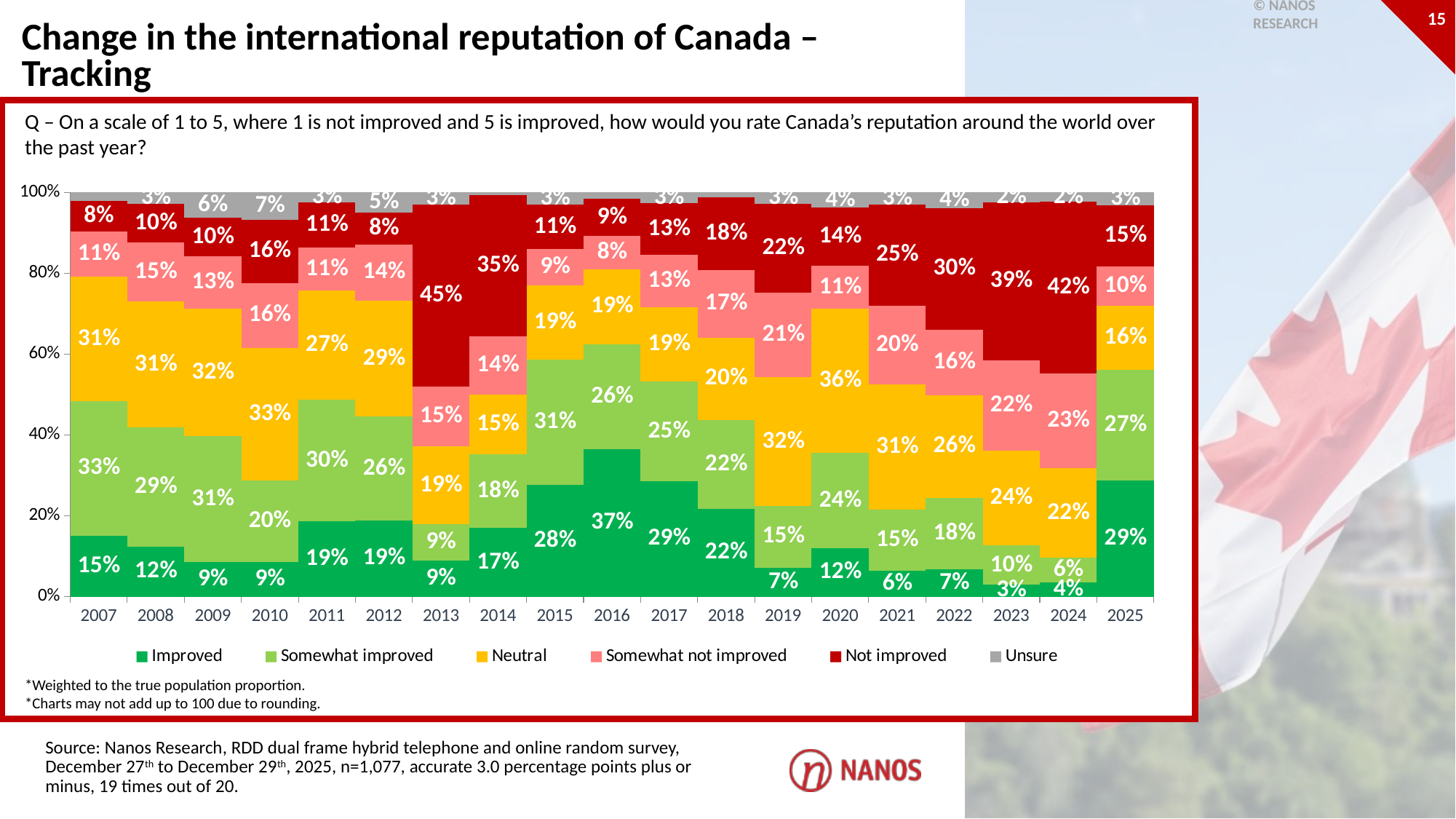
What is the "Somewhat not improved" value for 2023? 22% How many years are shown on the x axis of the chart? 19 In which year was the "Improved" share the lowest? 2023 Did the "Not improved" share rise or fall from 2021 to 2024? Rise Which year had a larger "Neutral" share, 2019 or 2020? 2020 How many series does the legend list? 6 What percentage of respondents said Canada's reputation was "Improved" in 2025? 29% By how many percentage points did the "Not improved" share fall from 2024 to 2025? 27 percentage points What colour represents the "Unsure" series in the legend? Grey What is the "Not improved" value for 2024? 42% In which year was the "Improved" share the highest? 2016 What kind of chart is shown on the slide? Stacked bar chart